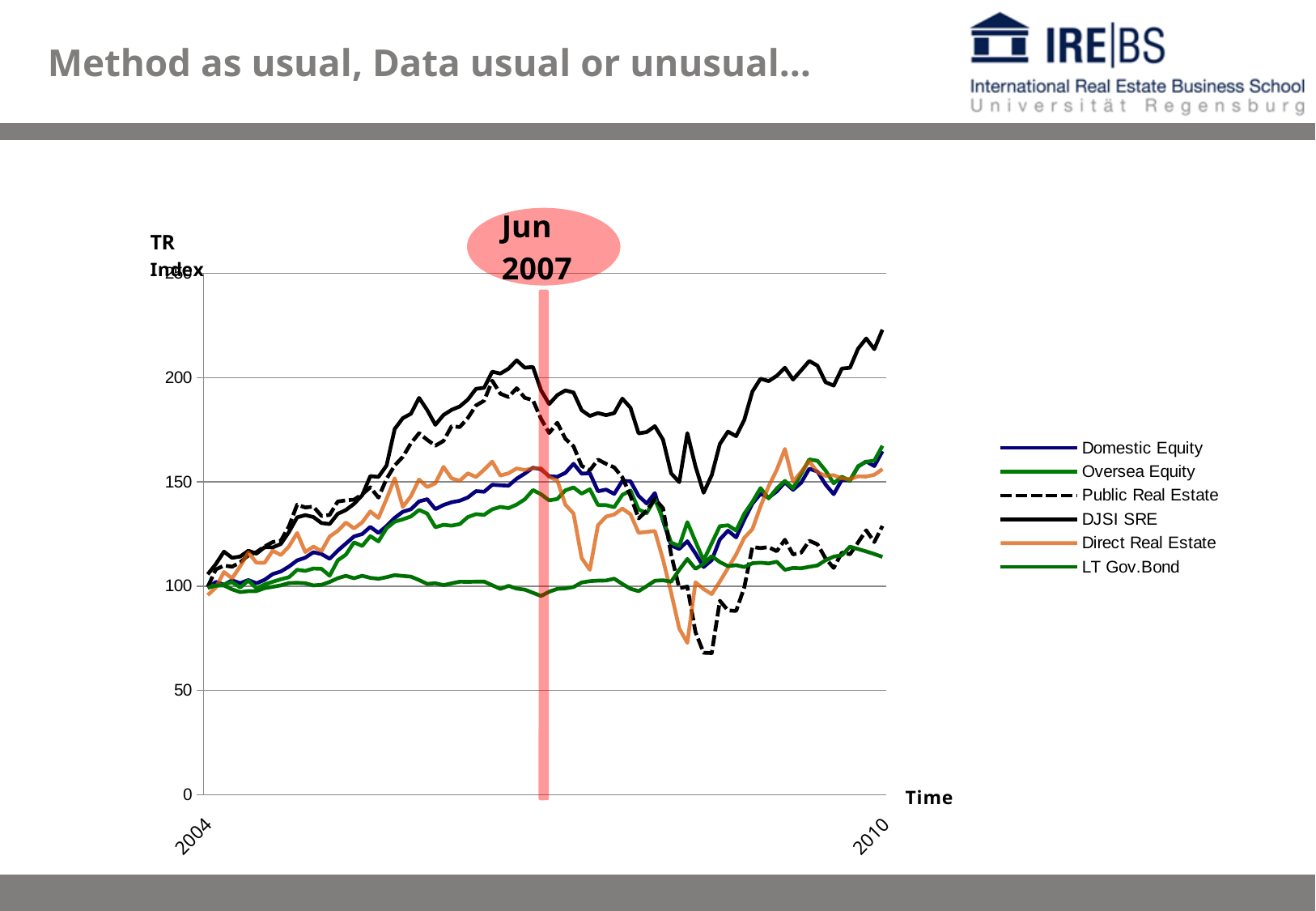
Which series falls to the lowest value anywhere on the chart? Public Real Estate Does the DJSI SRE line overall rise or fall from 2004 to 2010? rise Is the value of DJSI SRE at the right end of the chart greater or less than 200? greater Is the lowest point of the Public Real Estate line greater or less than 100? less What label is given to the vertical axis of the chart? TR Index What kind of chart is shown on the slide? line chart What date is highlighted by the red marker on the chart? Jun 2007 How many series does the legend list? 6 Is the value of Domestic Equity at the right end of the chart greater or less than 150? greater Which series has the highest value at the right end of the chart (2010)? DJSI SRE At the right end of the chart, which is higher: DJSI SRE or Public Real Estate? DJSI SRE